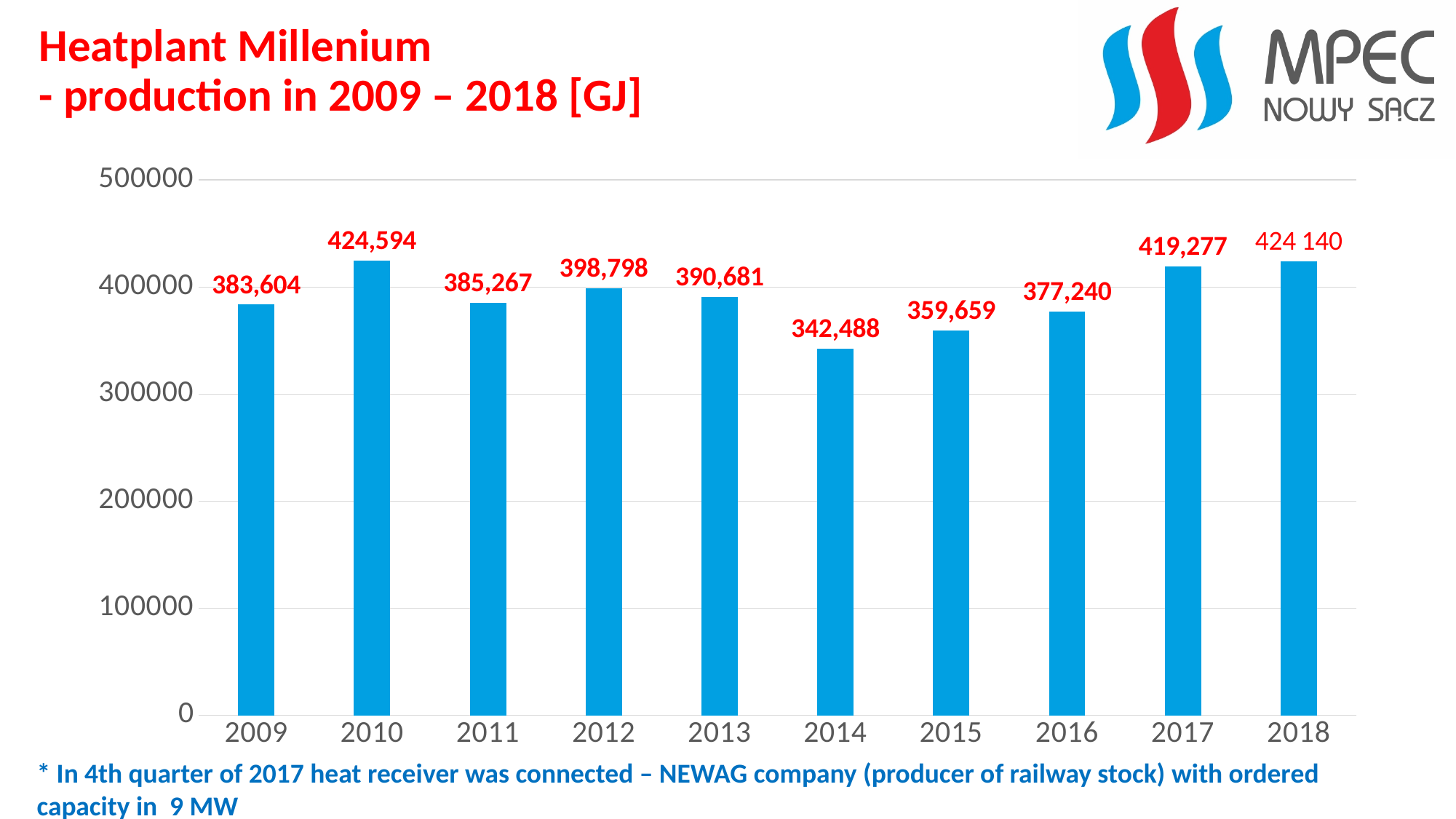
Which year had higher production, 2012 or 2015? 2012 What was the production in 2018? 424 140 How many years are shown on the chart? 10 What is the difference between the production in 2017 and in 2016? 42,037 Which year had the lowest production? 2014 Is the value for 2014 greater or less than 400000? less Did production rise or fall from 2014 to 2018? rise What is the difference between the production in 2010 and in 2009? 40,990 What kind of chart is shown on the slide? bar chart Which year had the highest production? 2010 What was the production in 2014? 342,488 What was the production in 2017? 419,277